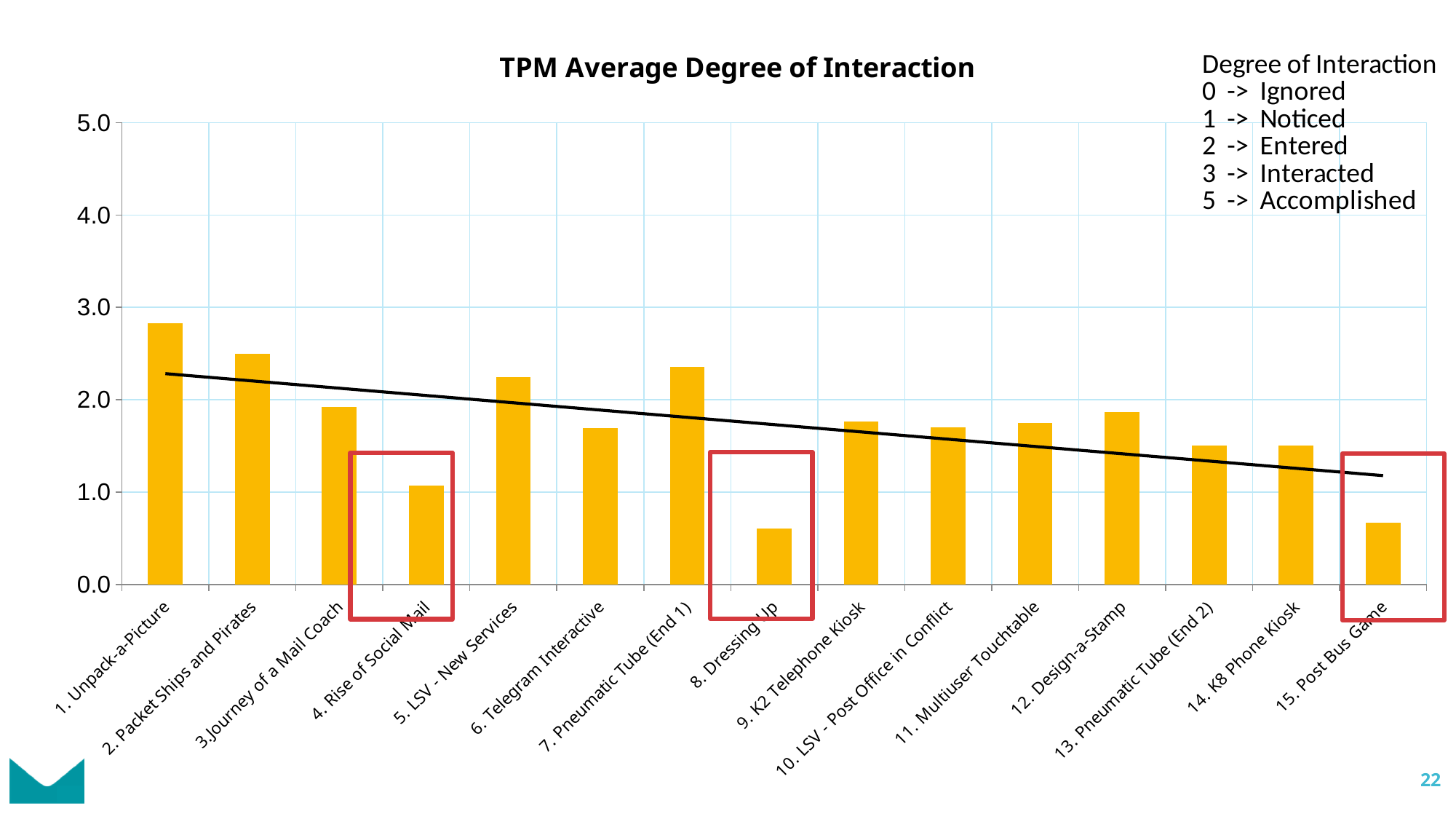
Which has a higher value, 12. Design-a-Stamp or 14. K8 Phone Kiosk? 12. Design-a-Stamp What is the title of the chart? TPM Average Degree of Interaction Is the value for 1. Unpack-a-Picture greater or less than 2.0? greater Is the value for 6. Telegram Interactive greater or less than 2.0? less What kind of chart is shown on the slide? bar chart Is the value for 7. Pneumatic Tube (End 1) greater or less than 2.0? greater Which exhibit has the highest average degree of interaction? 1. Unpack-a-Picture How many exhibits (categories) are plotted on the x axis? 15 Does the black trend line rise or fall from left to right across the exhibits? fall Which has a higher value, 4. Rise of Social Mail or 8. Dressing Up? 4. Rise of Social Mail